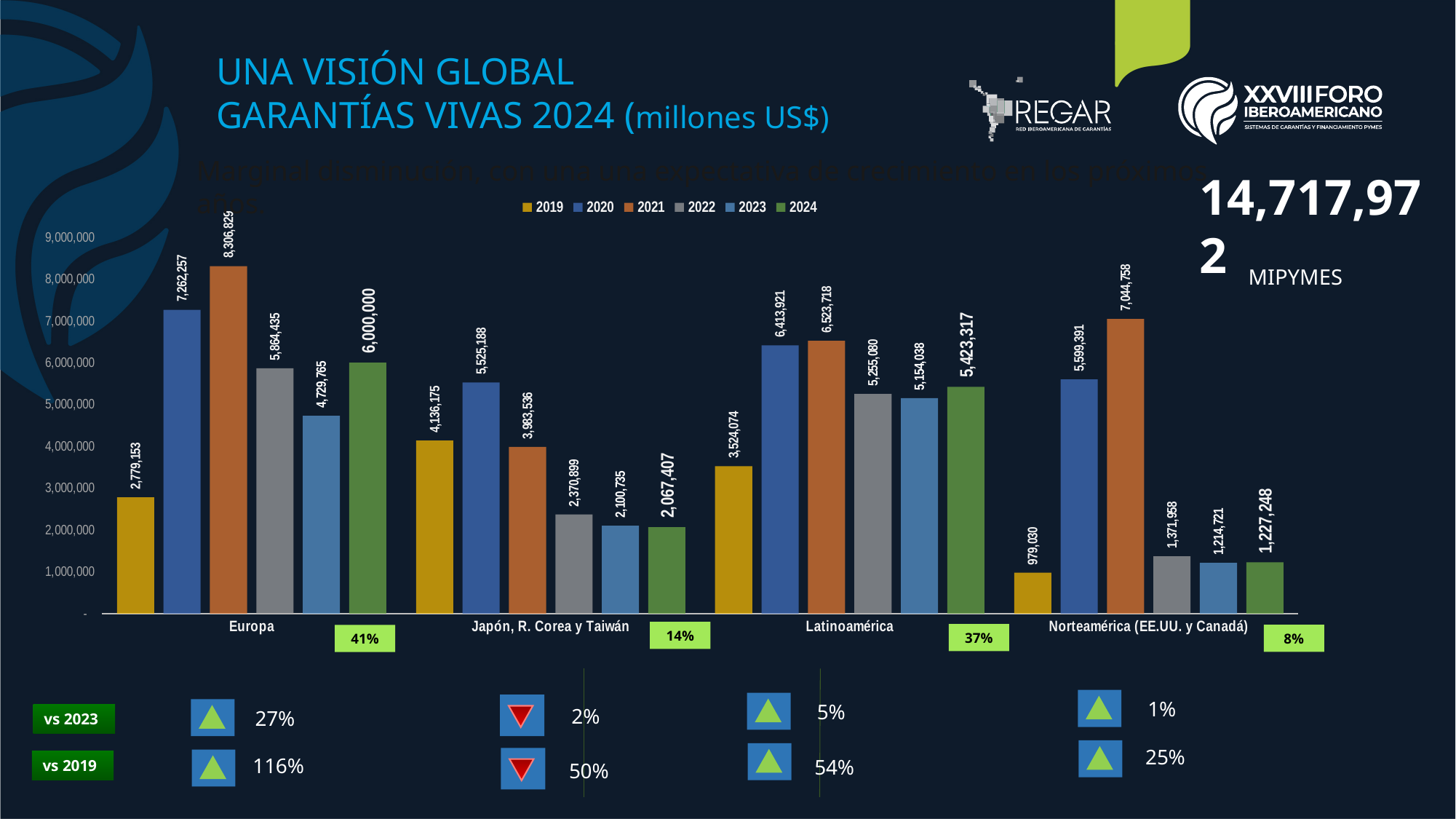
What is the 2024 value for Europa? 6,000,000 How many regions are shown on the x axis? 4 What is the 2021 value for Norteamérica (EE.UU. y Canadá)? 7,044,758 How many series does the legend list? 6 Is the 2022 value for Latinoamérica greater or less than 5,000,000? greater Which is larger for Japón, R. Corea y Taiwán: the 2020 value or the 2019 value? 2020 What is the difference between the 2021 and 2019 values for Europa? 5,527,676 Which region has the lowest 2019 value? Norteamérica (EE.UU. y Canadá) Which region has the highest 2024 value? Europa What is the 2019 value for Latinoamérica? 3,524,074 What kind of chart is shown? bar chart Do the values for Japón, R. Corea y Taiwán rise or fall from 2021 to 2024? fall